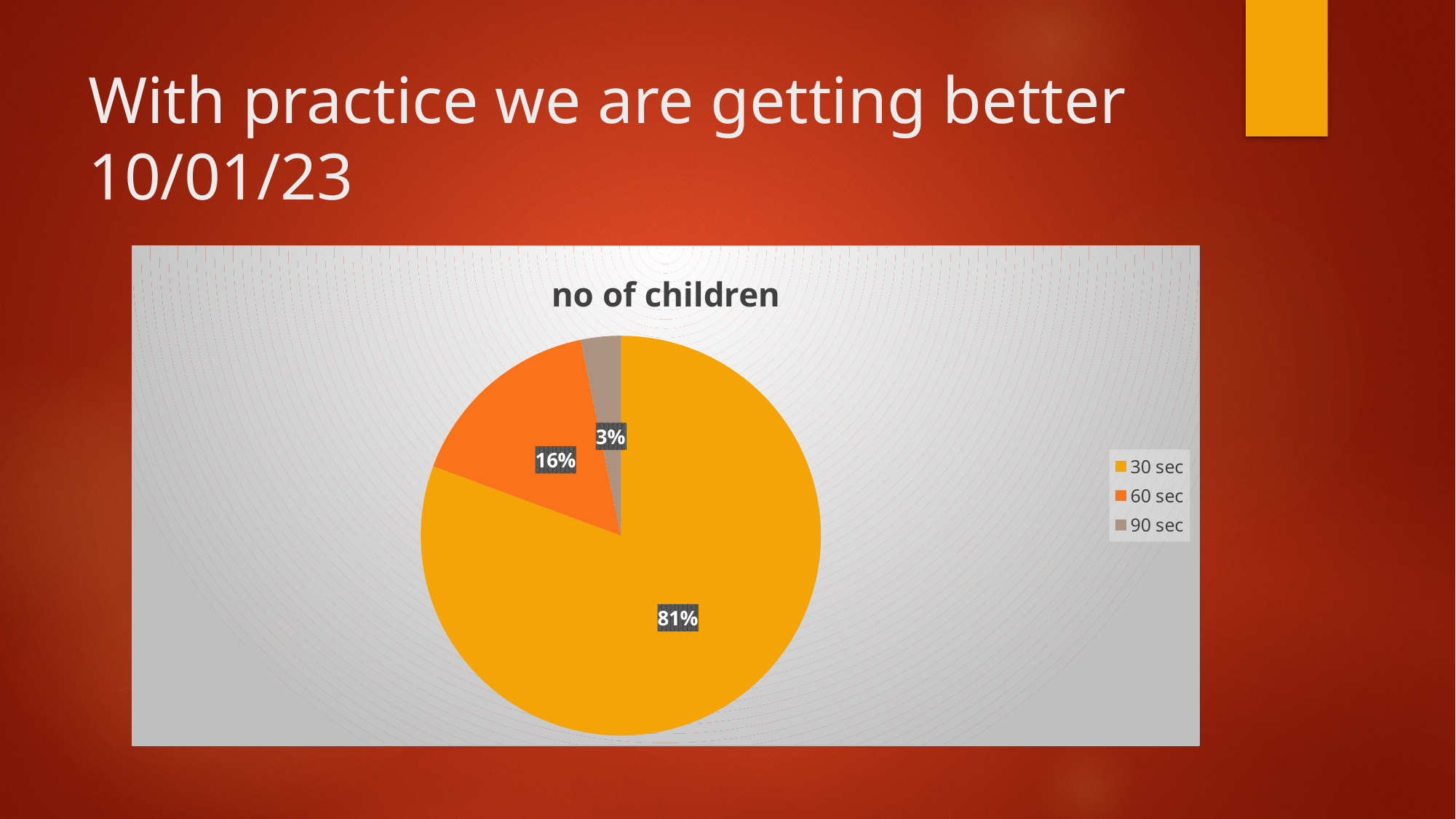
Which category has the largest slice of the pie? 30 sec What share of the pie does the 90 sec slice take? 3% Which category has the smallest slice of the pie? 90 sec What share of the pie does the 60 sec slice take? 16% What share of the pie does the 30 sec slice take? 81% How many categories does the legend list? 3 What is the title of the chart? no of children Which slice is larger, 60 sec or 90 sec? 60 sec What is the difference in percentage points between the 30 sec slice and the 60 sec slice? 65 What colour is the 60 sec slice in the pie chart? orange What kind of chart is shown on the slide? pie chart How many slices does the pie chart have? 3